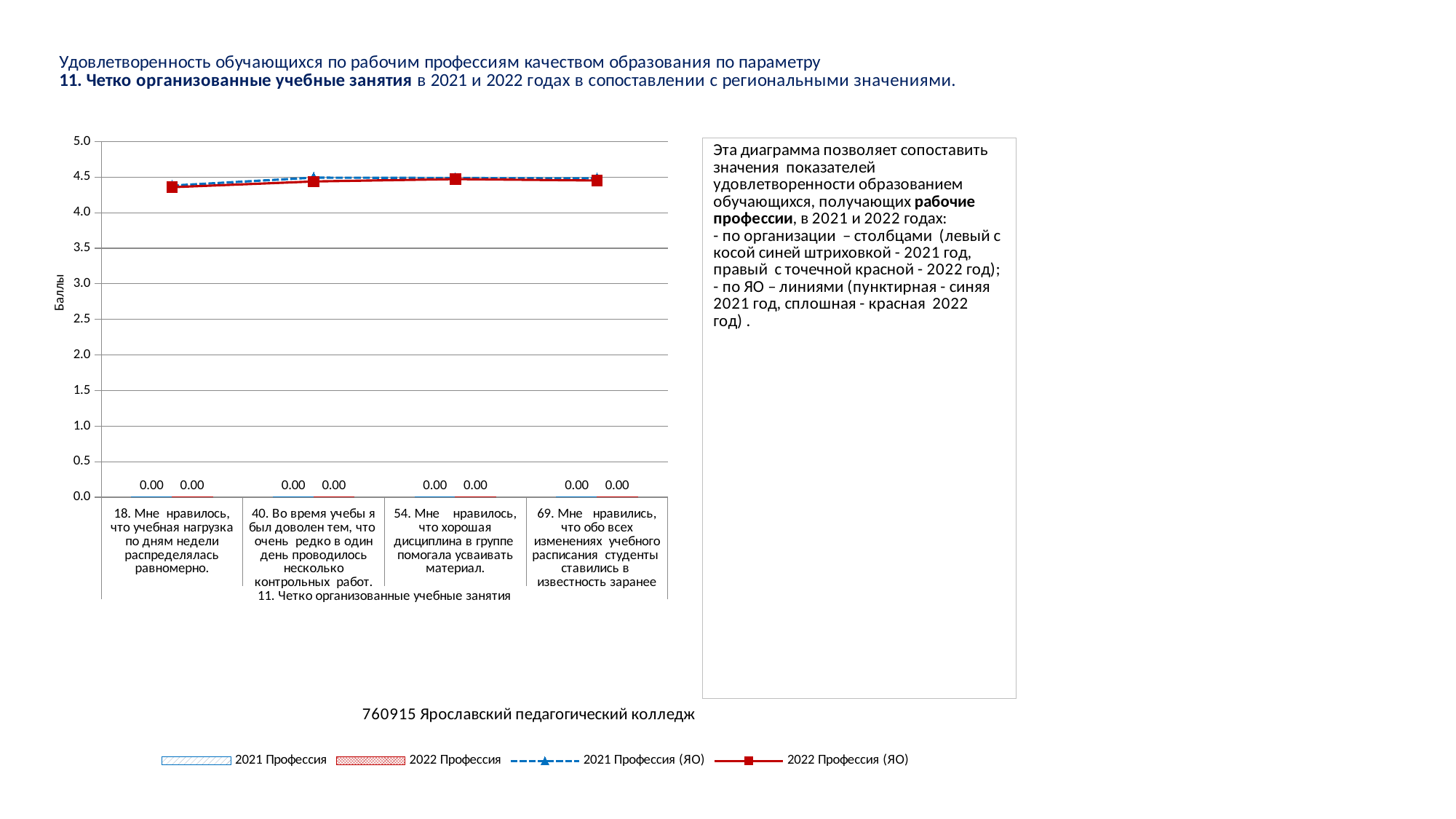
What is the value of the 2022 Профессия bar for category "69. Мне нравились, что обо всех изменениях учебного расписания студенты ставились в известность заранее"? 0.00 What is the value of the 2021 Профессия bar for category "18. Мне нравилось, что учебная нагрузка по дням недели распределялась равномерно."? 0.00 What is the difference between the 2021 Профессия and 2022 Профессия bars for category "54. Мне нравилось, что хорошая дисциплина в группе помогала усваивать материал."? 0.00 Is the value of the 2021 Профессия (ЯО) line for category "54. Мне нравилось, что хорошая дисциплина в группе помогала усваивать материал." greater or less than 4.0? greater Is the value of the 2022 Профессия (ЯО) line for category "18. Мне нравилось, что учебная нагрузка по дням недели распределялась равномерно." greater or less than 4.5? less What is the label of the vertical axis of the chart? Баллы What kind of chart is shown on the slide? Combined bar and line chart How many categories are shown on the x axis of the chart? 4 What is the value of the 2022 Профессия bar for category "40. Во время учебы я был доволен тем, что очень редко в один день проводилось несколько контрольных работ."? 0.00 Is the value of the 2022 Профессия (ЯО) line for category "18. Мне нравилось, что учебная нагрузка по дням недели распределялась равномерно." greater or less than 4.0? greater Does the 2022 Профессия (ЯО) line rise or fall from category 18 to category 40? rise How many series does the chart legend list? 4